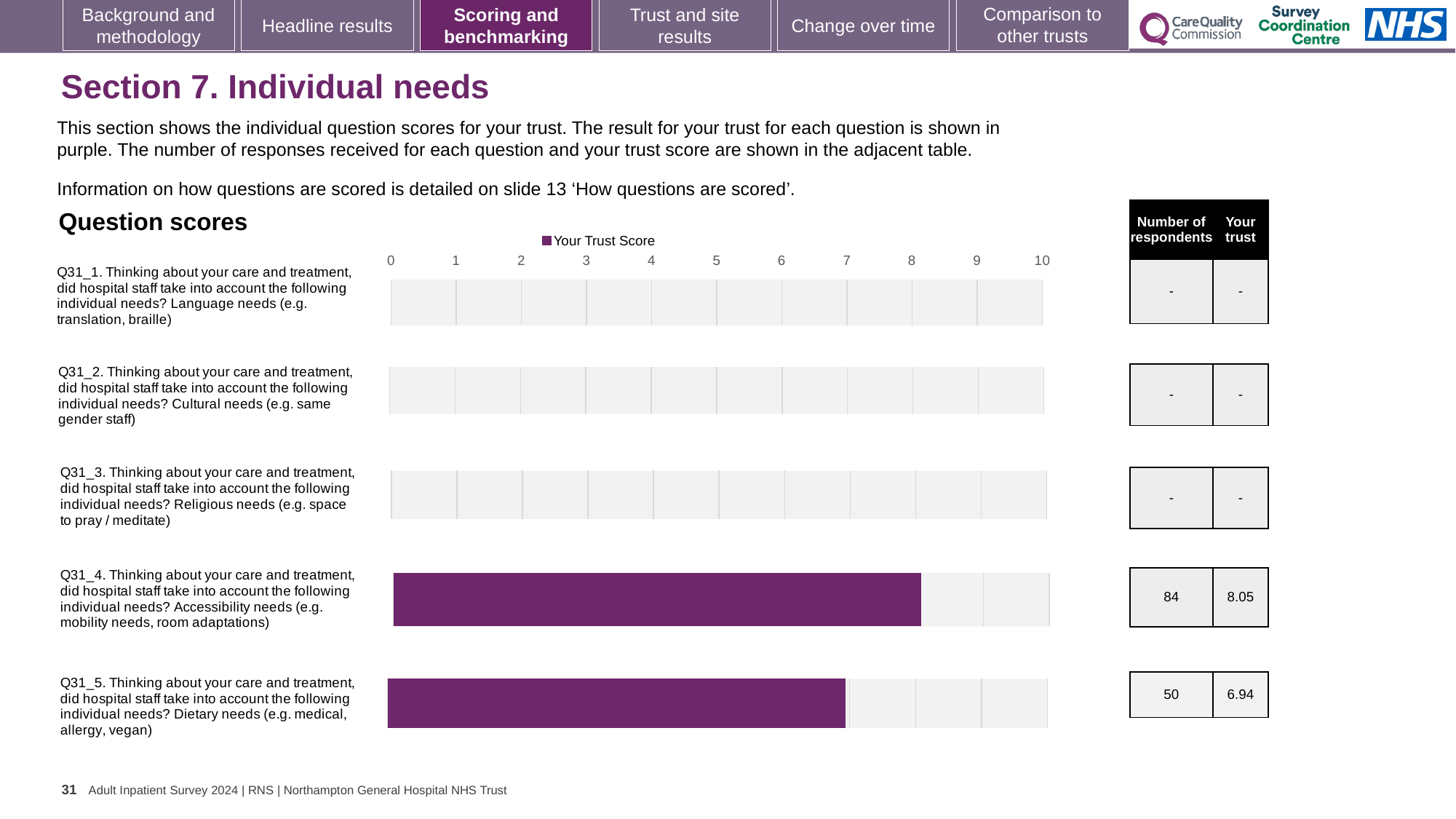
What is the trust score for Q31_4 (Accessibility needs)? 8.05 How many questions are listed on the chart? 5 How many respondents answered Q31_4 (Accessibility needs)? 84 What type of chart is used to show the question scores? Bar chart Is the trust score for Q31_5 (Dietary needs) greater or less than 7? less Is the trust score for Q31_4 (Accessibility needs) greater or less than 8? greater What series does the chart legend list? Your Trust Score Which question has the highest trust score shown on the chart? Q31_4 (Accessibility needs) Which has a higher trust score, Q31_4 (Accessibility needs) or Q31_5 (Dietary needs)? Q31_4 (Accessibility needs) What is the difference between the trust scores for Q31_4 and Q31_5? 1.11 What is the trust score for Q31_5 (Dietary needs)? 6.94 How many respondents answered Q31_5 (Dietary needs)? 50